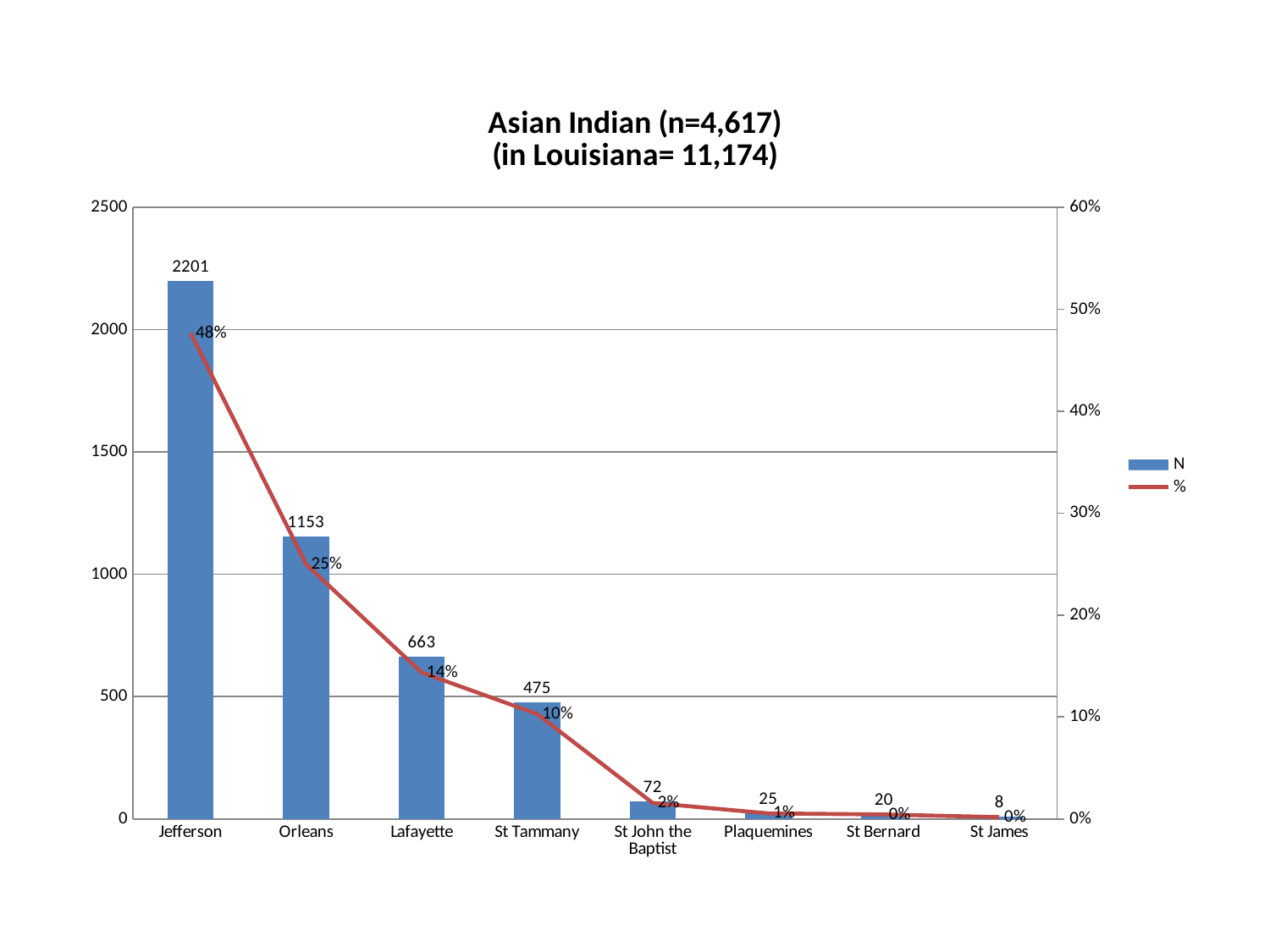
Which parish has the highest N value? Jefferson How many series does the legend list? 2 What is the N value for Jefferson? 2201 How many parishes are shown on the x axis? 8 Do the N values rise or fall from left to right along the x axis? fall What is the title of the chart? Asian Indian (n=4,617) (in Louisiana= 11,174) What is the N value for Lafayette? 663 What is the N value for St John the Baptist? 72 What percentage is shown for Orleans? 25% What is the difference in N between Jefferson and Orleans? 1048 Which has a larger N value, St Tammany or Lafayette? Lafayette Which parish has the lowest N value? St James